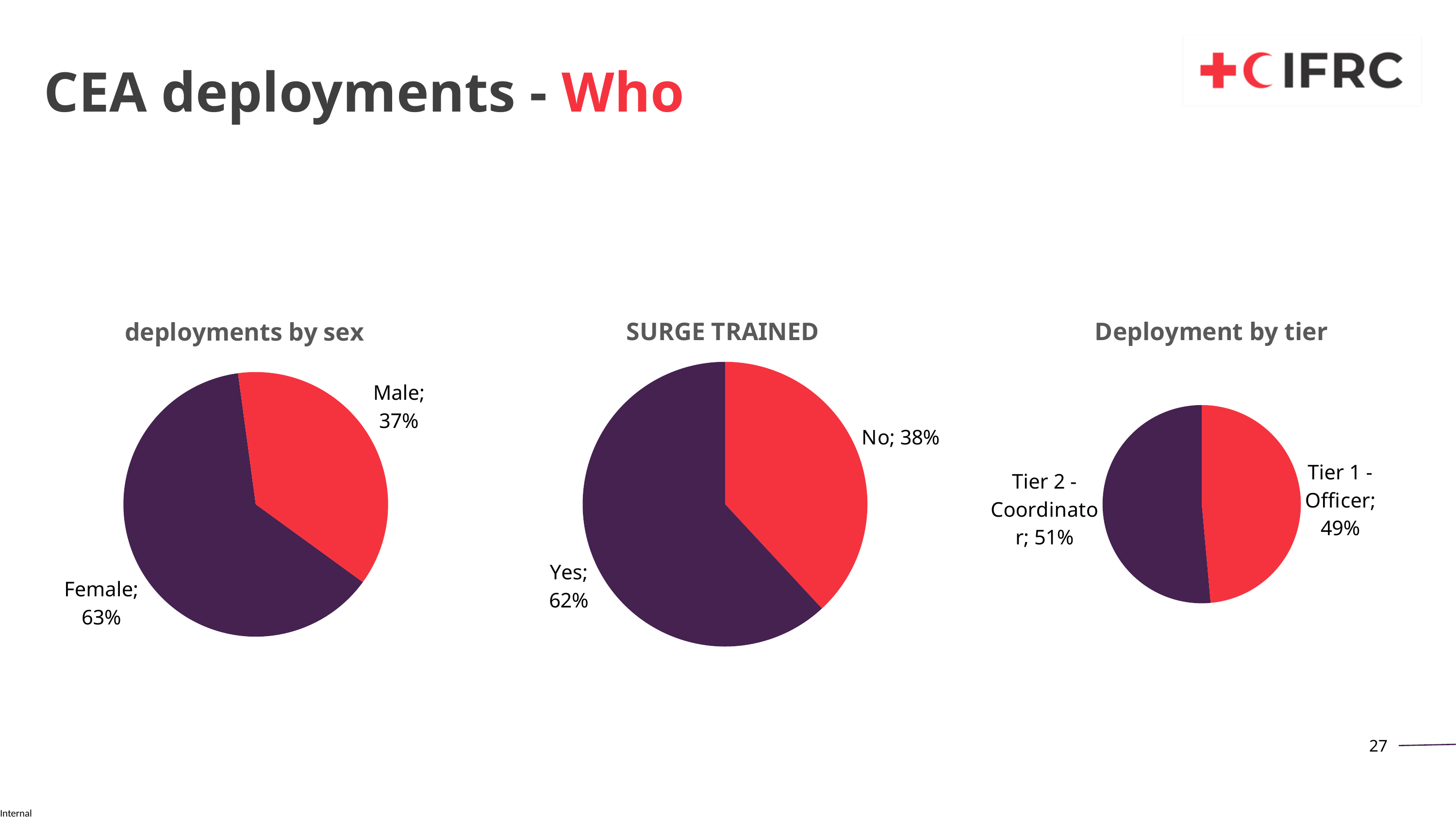
In the 'deployments by sex' chart, what share of deployments is Male? 37% In the 'SURGE TRAINED' chart, which category has the smaller share? No In the 'deployments by sex' chart, which category has the larger share? Female In the 'deployments by sex' chart, what is the difference in percentage points between Female and Male? 26 In the 'SURGE TRAINED' chart, what percentage answered No? 38% How many slices does the 'SURGE TRAINED' pie chart have? 2 In the 'SURGE TRAINED' chart, what percentage answered Yes? 62% In the 'Deployment by tier' chart, what share is Tier 1 - Officer? 49% In the 'deployments by sex' chart, what share of deployments is Female? 63% In the 'Deployment by tier' chart, what share is Tier 2 - Coordinator? 51% What kind of chart is the 'Deployment by tier' chart? Pie chart In the 'SURGE TRAINED' chart, what is the difference in percentage points between Yes and No? 24